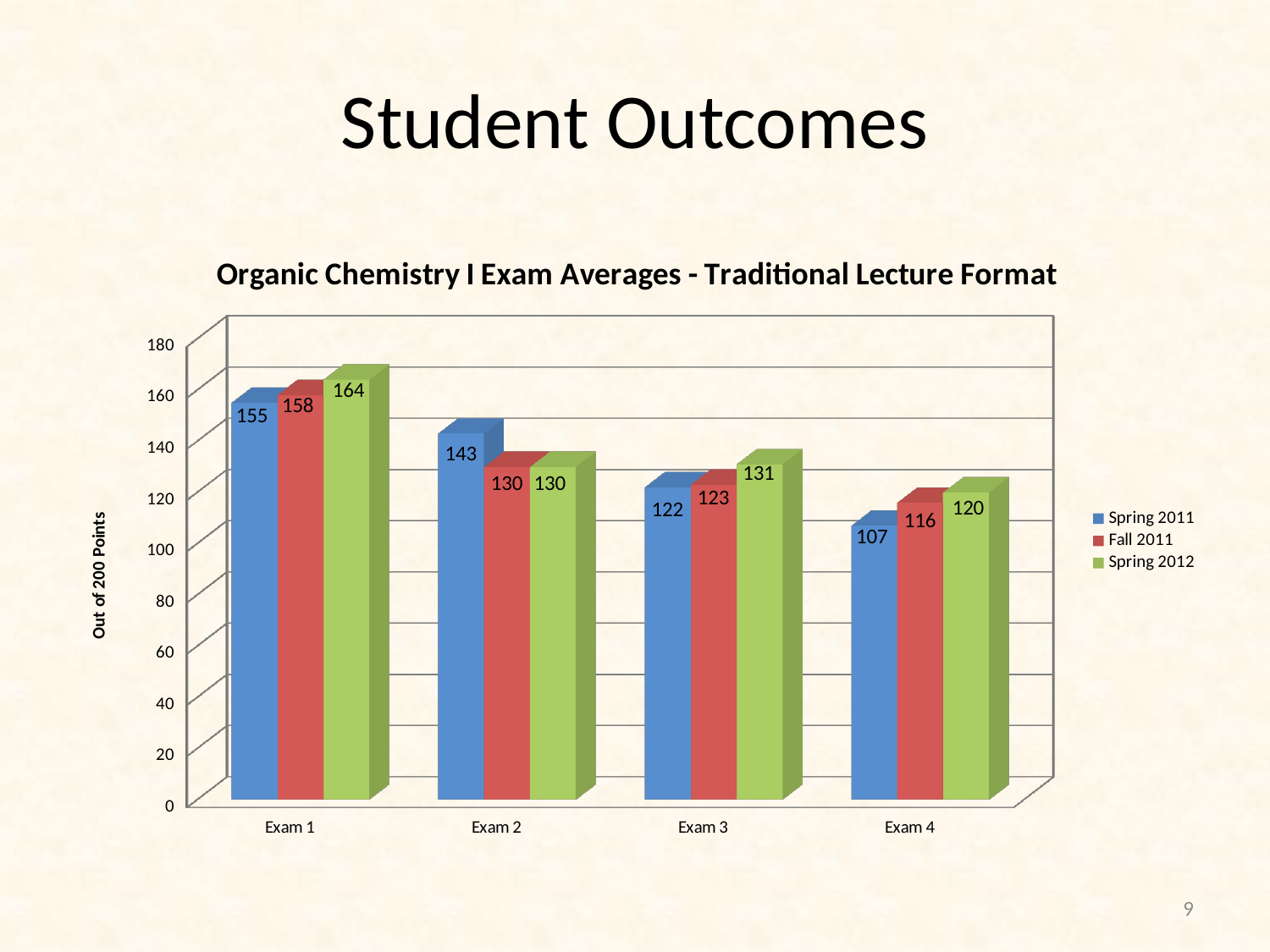
Which is larger for Exam 2: the Spring 2011 average or the Fall 2011 average? Spring 2011 Which exam has the lowest Spring 2011 average? Exam 4 What is the title of the chart? Organic Chemistry I Exam Averages - Traditional Lecture Format How many series does the legend list? 3 What is the Spring 2011 average for Exam 2? 143 Which exam has the highest Spring 2012 average? Exam 1 What kind of chart is shown on the slide? Bar chart Is the Fall 2011 average for Exam 4 greater or less than 100? greater How many exams are shown on the x axis? 4 What is the Fall 2011 average for Exam 3? 123 What is the difference between the Spring 2012 and Spring 2011 averages for Exam 1? 9 What is the Spring 2012 average for Exam 4? 120